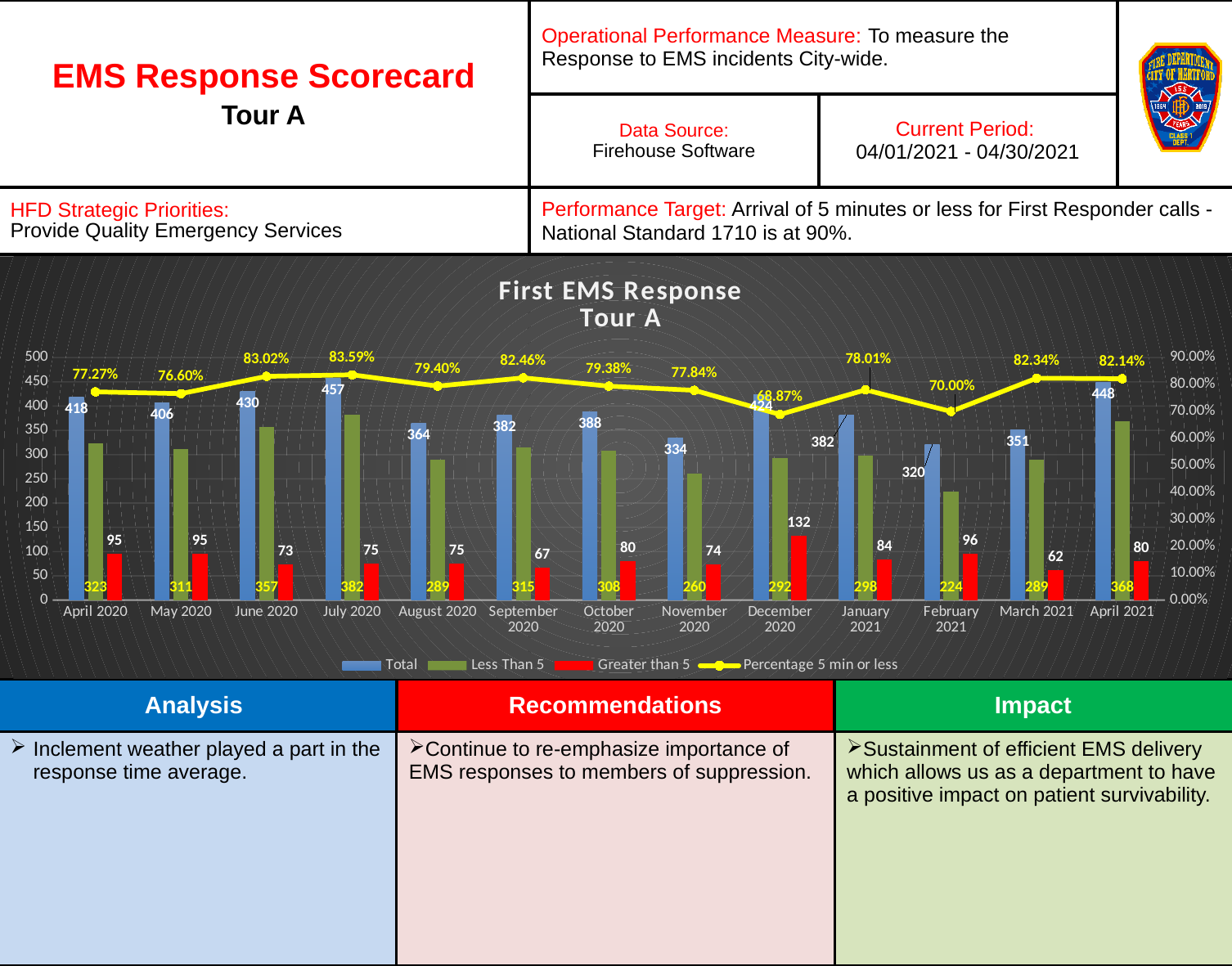
What is the Total value for July 2020? 457 Which month has the highest Total value? July 2020 What is the difference between the Total for April 2021 and the Total for April 2020? 30 How many series does the legend list? 4 What kind of chart is this? bar and line chart Which month has the lowest Percentage 5 min or less? December 2020 Which is larger, the Less Than 5 value for June 2020 or for July 2020? July 2020 Which month has the lowest Greater than 5 value? March 2021 Which legend entry is shown as a yellow line? Percentage 5 min or less What is the Percentage 5 min or less for February 2021? 70.00% How many months are shown on the x axis? 13 What is the Greater than 5 value for December 2020? 132